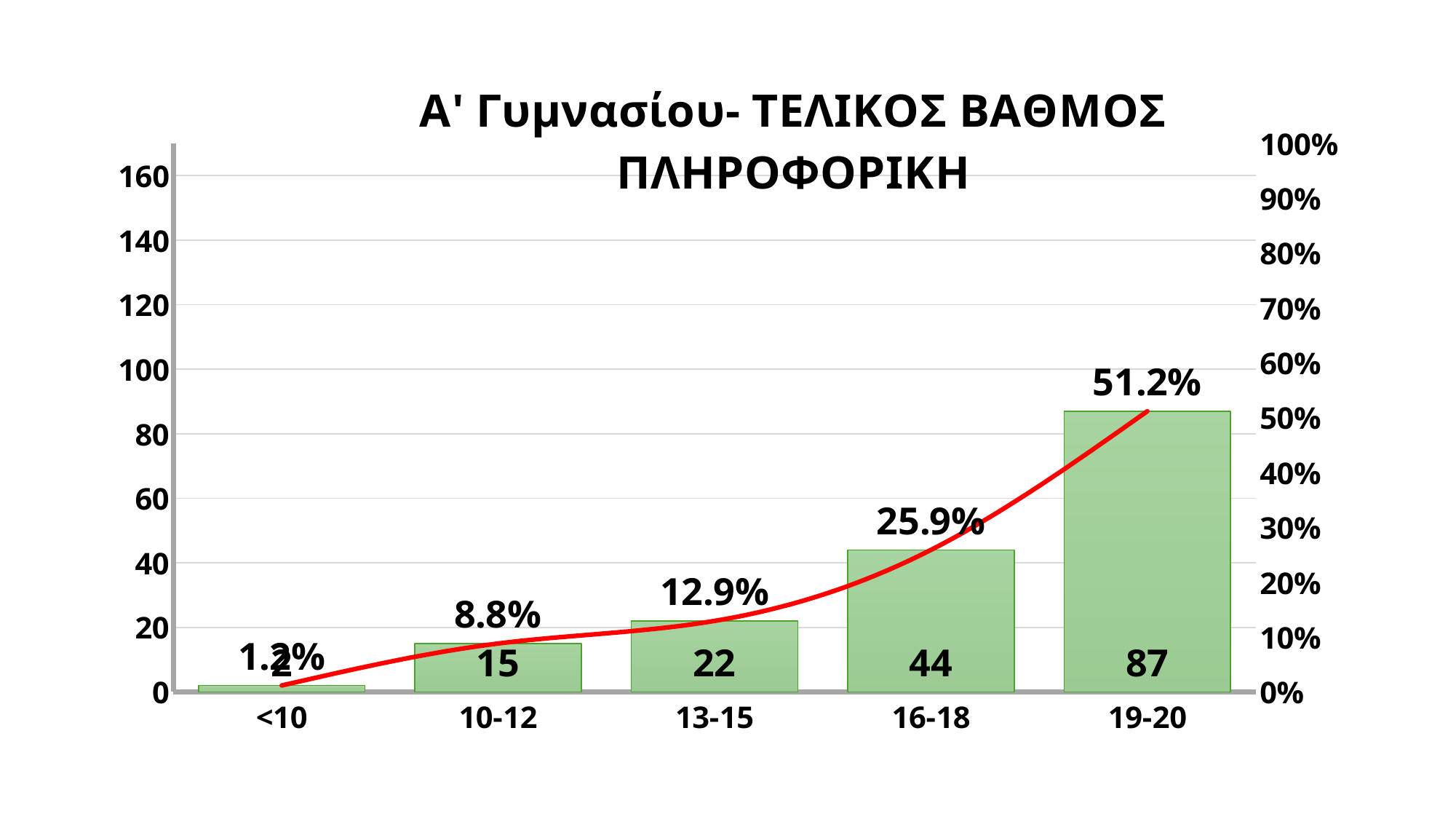
Do the bar values rise or fall from left to right along the x axis? rise Which category has the lowest count? <10 What percentage is shown for the 19-20 category? 51.2% What is the difference between the counts for 19-20 and 16-18? 43 What is the count for the 19-20 category? 87 How many categories are shown on the x axis? 5 What is the count for the 13-15 category? 22 What percentage is shown for the 16-18 category? 25.9% What is the count for the 10-12 category? 15 What percentage is shown for the 13-15 category? 12.9% What is the count for the 16-18 category? 44 Which category has the highest count? 19-20